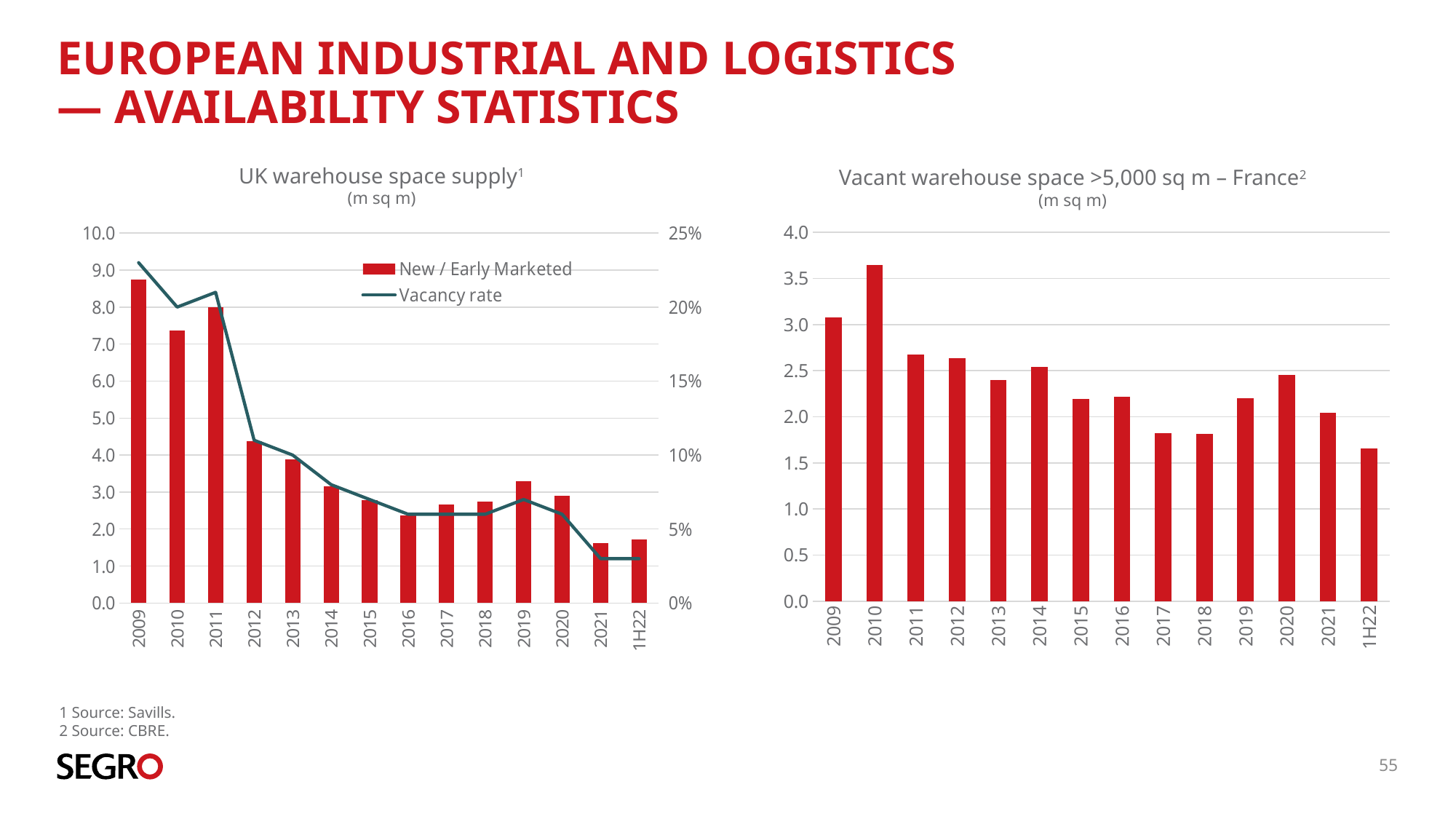
On the Vacant warehouse space >5,000 sq m – France chart, is the value for 1H22 greater or less than 2.0? less On the UK warehouse space supply chart, is the New / Early Marketed value for 2009 greater or less than 8.0? greater On the UK warehouse space supply chart, is the vacancy rate for 2021 greater or less than 5%? less On the UK warehouse space supply chart, which year has the highest New / Early Marketed bar? 2009 How many series does the legend of the UK warehouse space supply chart list? 2 How many periods are shown on the x axis of the Vacant warehouse space >5,000 sq m – France chart? 14 On the UK warehouse space supply chart, does the vacancy rate generally rise or fall from 2009 to 1H22? fall On the UK warehouse space supply chart, which is larger, the New / Early Marketed bar for 2018 or for 2019? 2019 On the Vacant warehouse space >5,000 sq m – France chart, which year has the highest bar? 2010